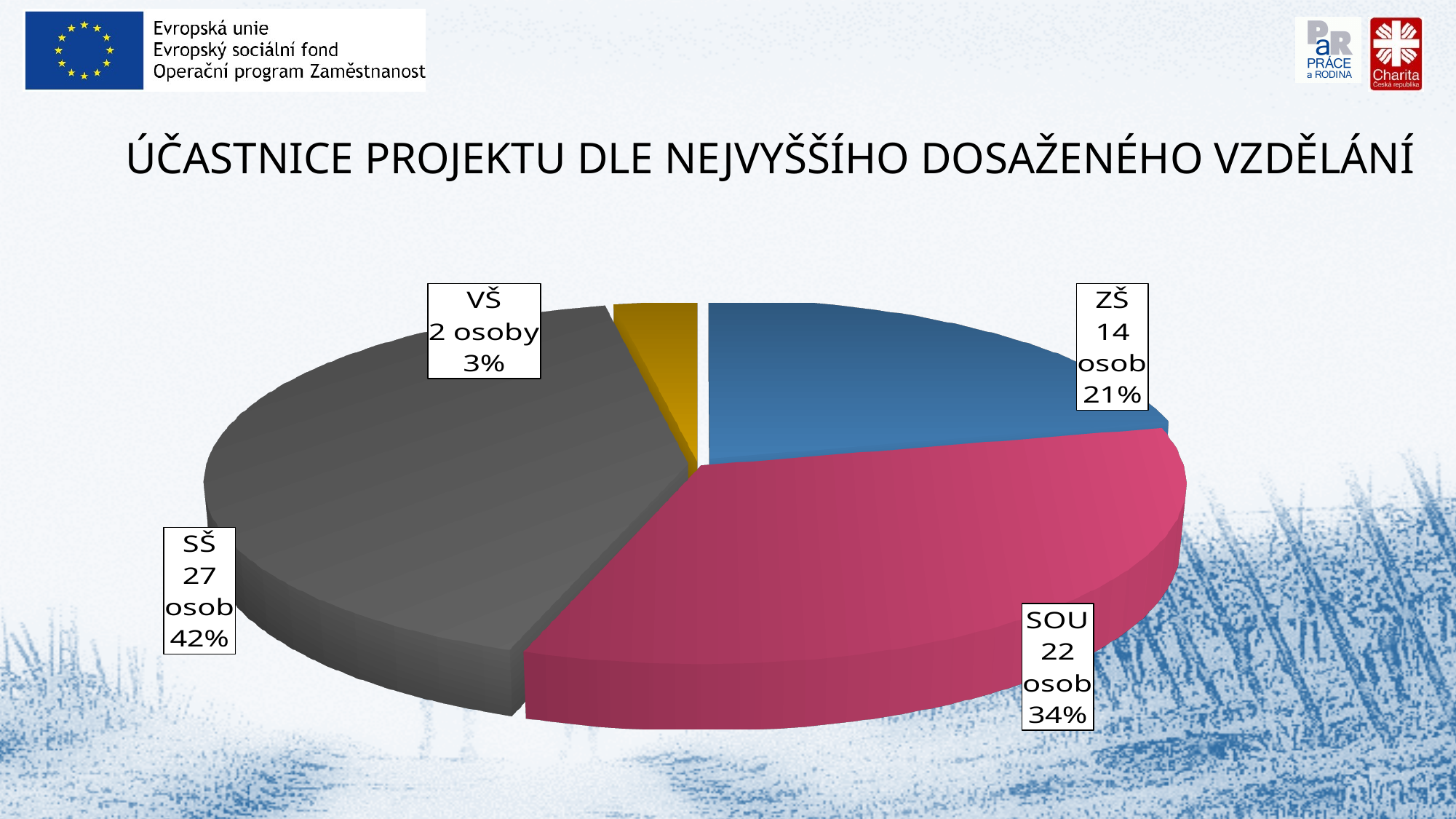
How many slices does the pie chart have? 4 What percentage share does the SOU slice have? 34% How many people are in the ZŠ category? 14 osob How many people are in the SŠ category? 27 osob Which category has more people, ZŠ or SOU? SOU Which category has the smallest share of the pie? VŠ What percentage share does the VŠ slice have? 3% What is the title of the chart? ÚČASTNICE PROJEKTU DLE NEJVYŠŠÍHO DOSAŽENÉHO VZDĚLÁNÍ What is the difference in number of people between SŠ and SOU? 5 What is the total number of people across all four categories? 65 What kind of chart is shown on the slide? pie chart Which category has the largest share of the pie? SŠ